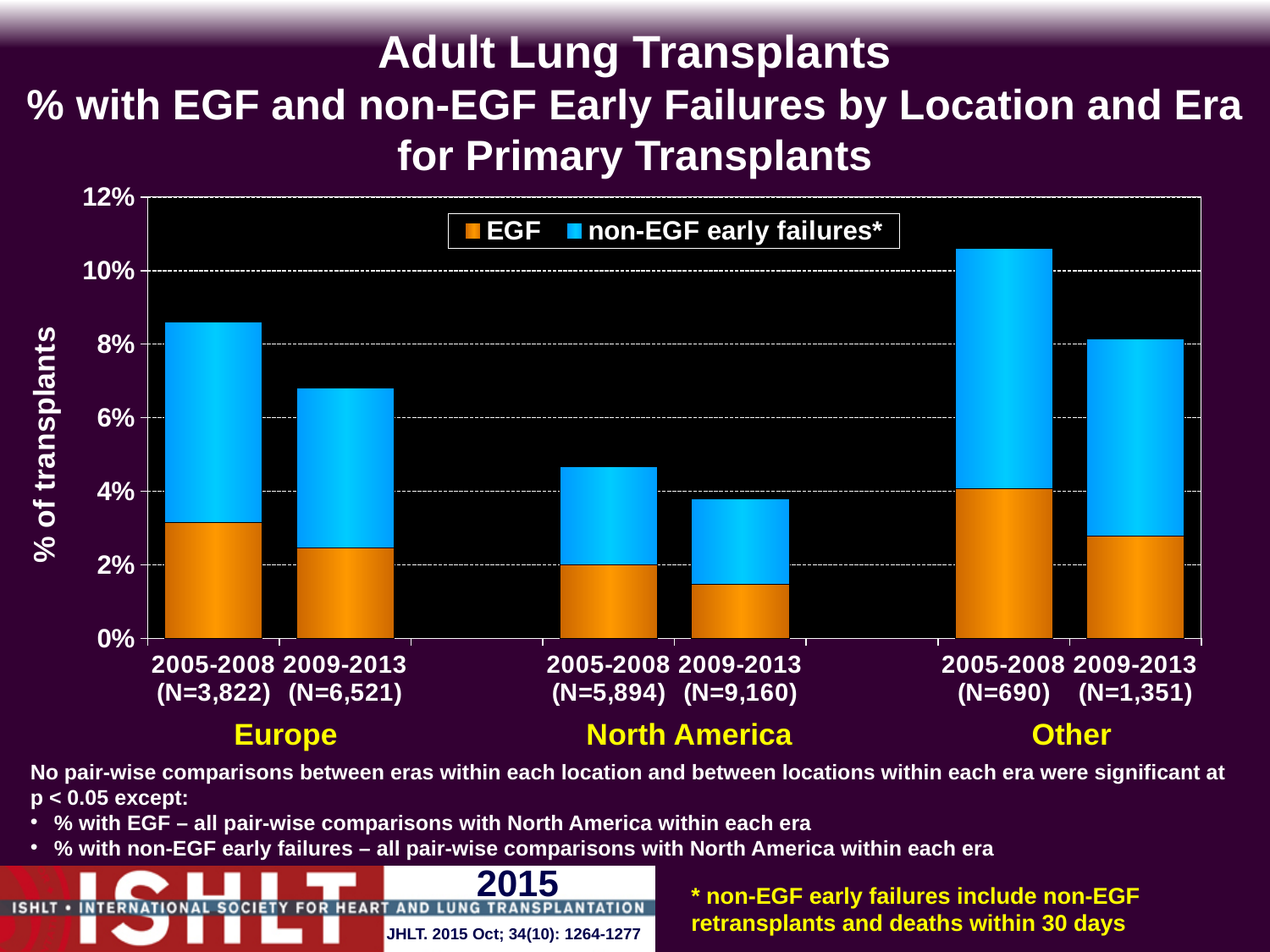
What kind of chart is shown on the slide? Stacked bar chart Is the total value for North America 2009-2013 greater or less than 4%? less Which bar has the highest total percentage of transplants? Other, 2005-2008 How many series does the legend list? 2 Is the total value for Europe 2009-2013 greater or less than 6%? greater Which bar has the lowest total percentage of transplants? North America, 2009-2013 Is the total value for Europe 2005-2008 greater or less than 8%? greater How many bars are plotted in the chart? 6 Which has a larger total percentage: Europe 2009-2013 or North America 2005-2008? Europe 2009-2013 What is the label of the y axis? % of transplants Within each location, does the total percentage rise or fall from the 2005-2008 era to the 2009-2013 era? Fall